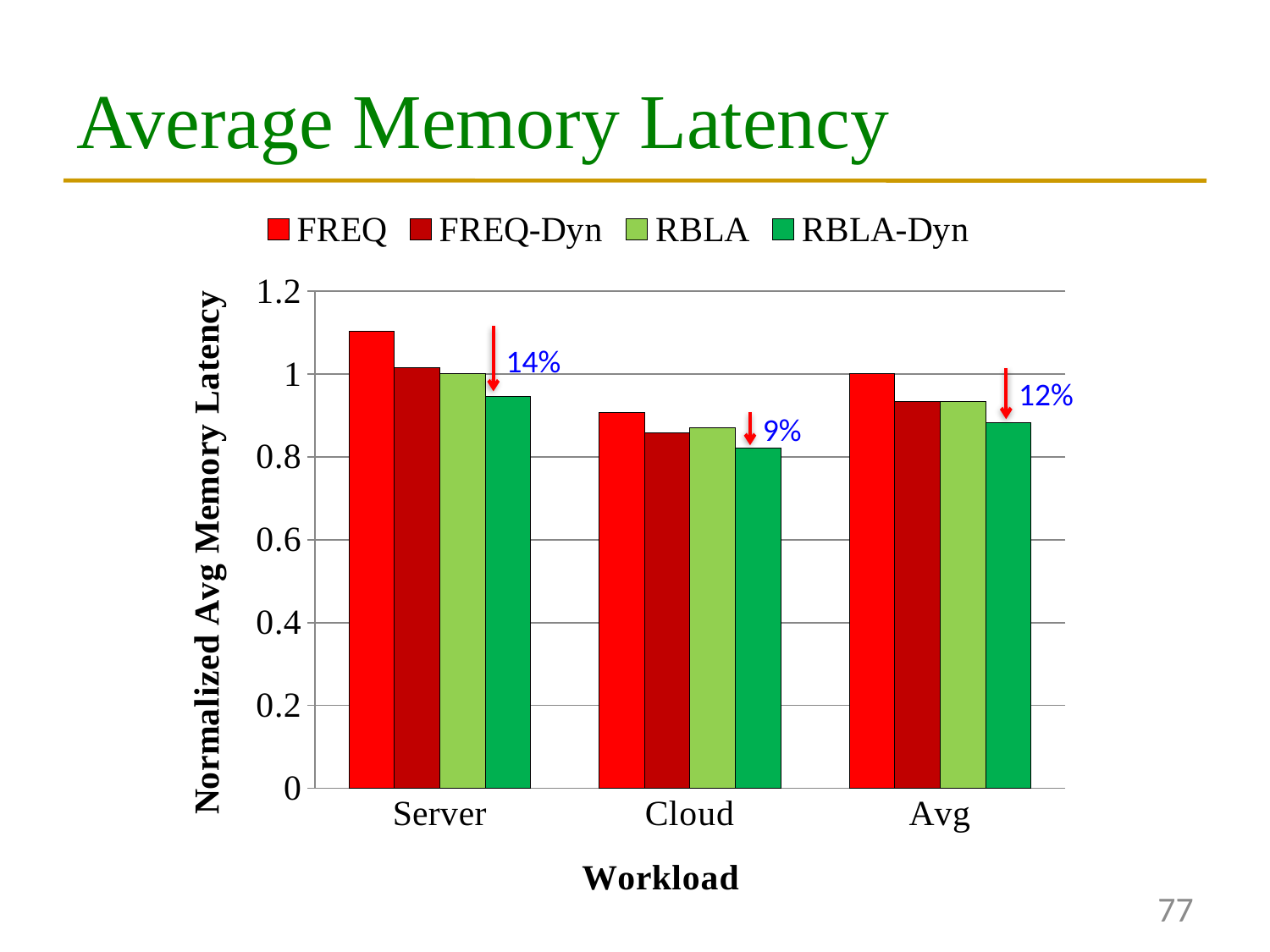
What percentage reduction is annotated above the RBLA-Dyn bar for the Server workload? 14% Is the value for FREQ on the Server workload greater or less than 1? greater Which series has the lowest normalized average memory latency for the Cloud workload? RBLA-Dyn What is the normalized average memory latency for FREQ on the Avg workload? 1 How many series does the legend list? 4 Which series has the highest normalized average memory latency for the Server workload? FREQ What percentage reduction is annotated next to the RBLA-Dyn bar for the Cloud workload? 9% Is the value for RBLA-Dyn on the Cloud workload greater or less than 1? less How many workload categories are shown on the x axis? 3 Is the value for FREQ-Dyn on the Cloud workload greater or less than 0.8? greater What kind of chart is shown on the slide? bar chart Which is larger, the FREQ value for Server or the FREQ value for Cloud? Server